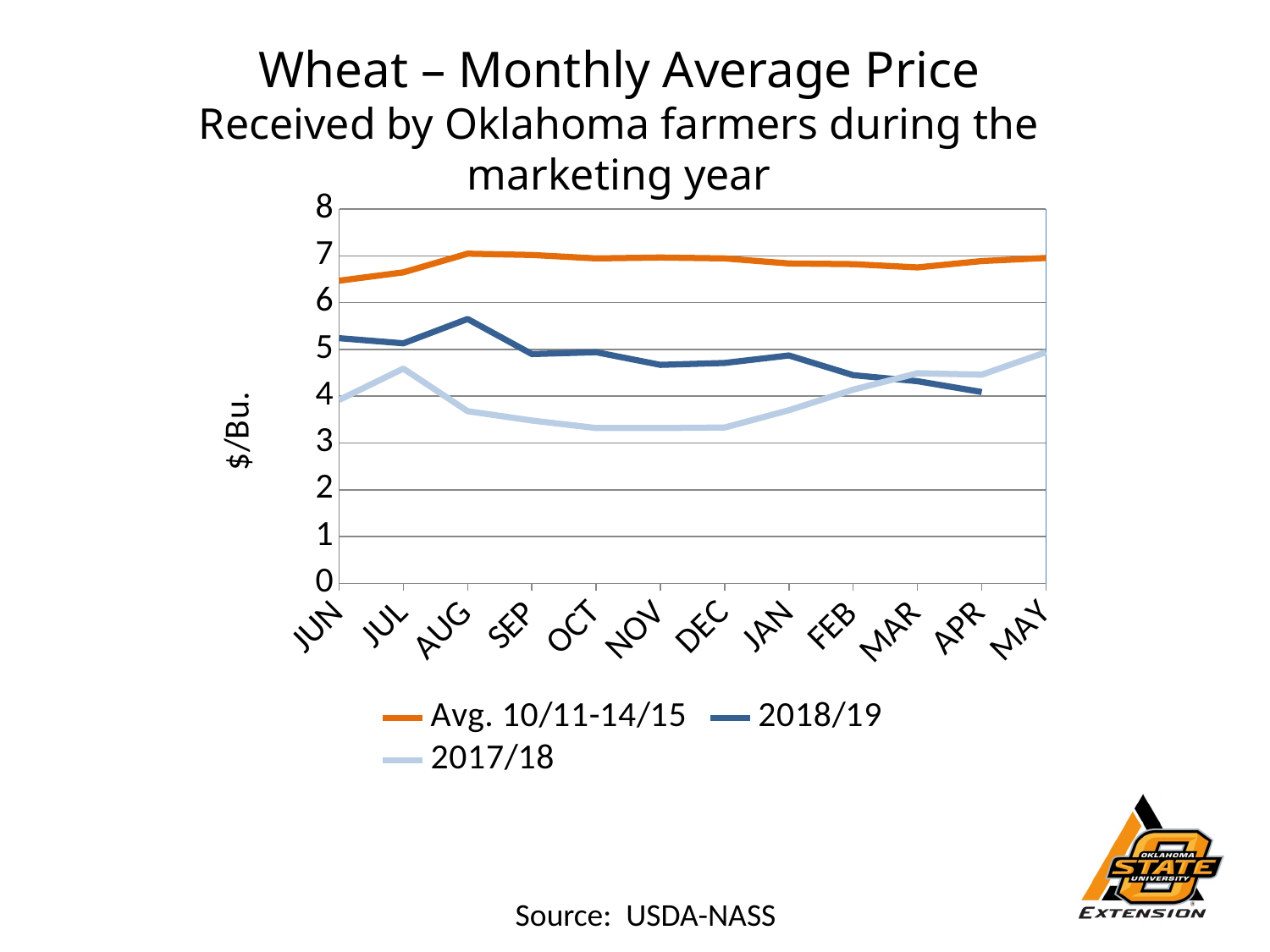
In which month does the 2018/19 series reach its lowest value? APR Is the value for the 2017/18 series in JUL greater or less than 4? greater Does the 2017/18 series rise or fall from DEC to MAY? rise Is the value for the 2017/18 series in OCT greater or less than 4? less Is the value for the 2018/19 series in AUG greater or less than 5? greater How many months are shown along the x axis? 12 What kind of chart is shown on the slide? Line chart How many series does the legend list? 3 In which month does the 2018/19 series reach its highest value? AUG In JUL, which series has the larger value: 2018/19 or 2017/18? 2018/19 What is the label on the y axis? $/Bu.